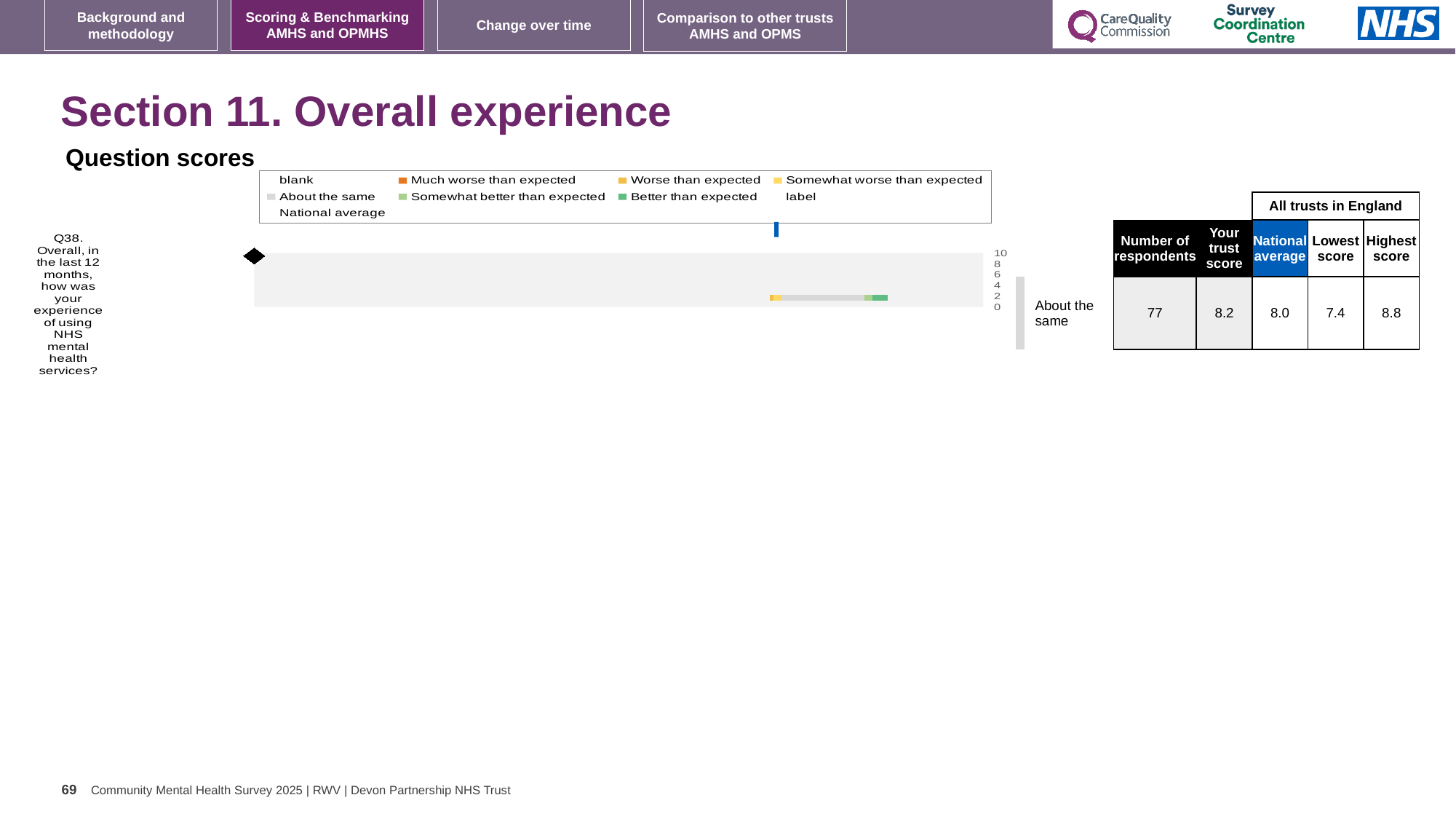
Which benchmark category is the trust's Q38 score placed in? About the same How many respondents answered Q38? 77 What question is plotted on the chart? Q38. Overall, in the last 12 months, how was your experience of using NHS mental health services? What is the lowest score among all trusts in England for Q38? 7.4 What is the maximum value shown on the chart's axis? 10 What is the national average score for Q38? 8.0 What is the highest score among all trusts in England for Q38? 8.8 What is the difference between the highest and lowest scores for Q38 across all trusts in England? 1.4 What is the difference between the trust score and the national average for Q38? 0.2 What is the trust's score for Q38 shown next to the chart? 8.2 Which is larger for Q38, the trust score or the national average? Trust score How many questions (categories) are plotted on the chart? 1